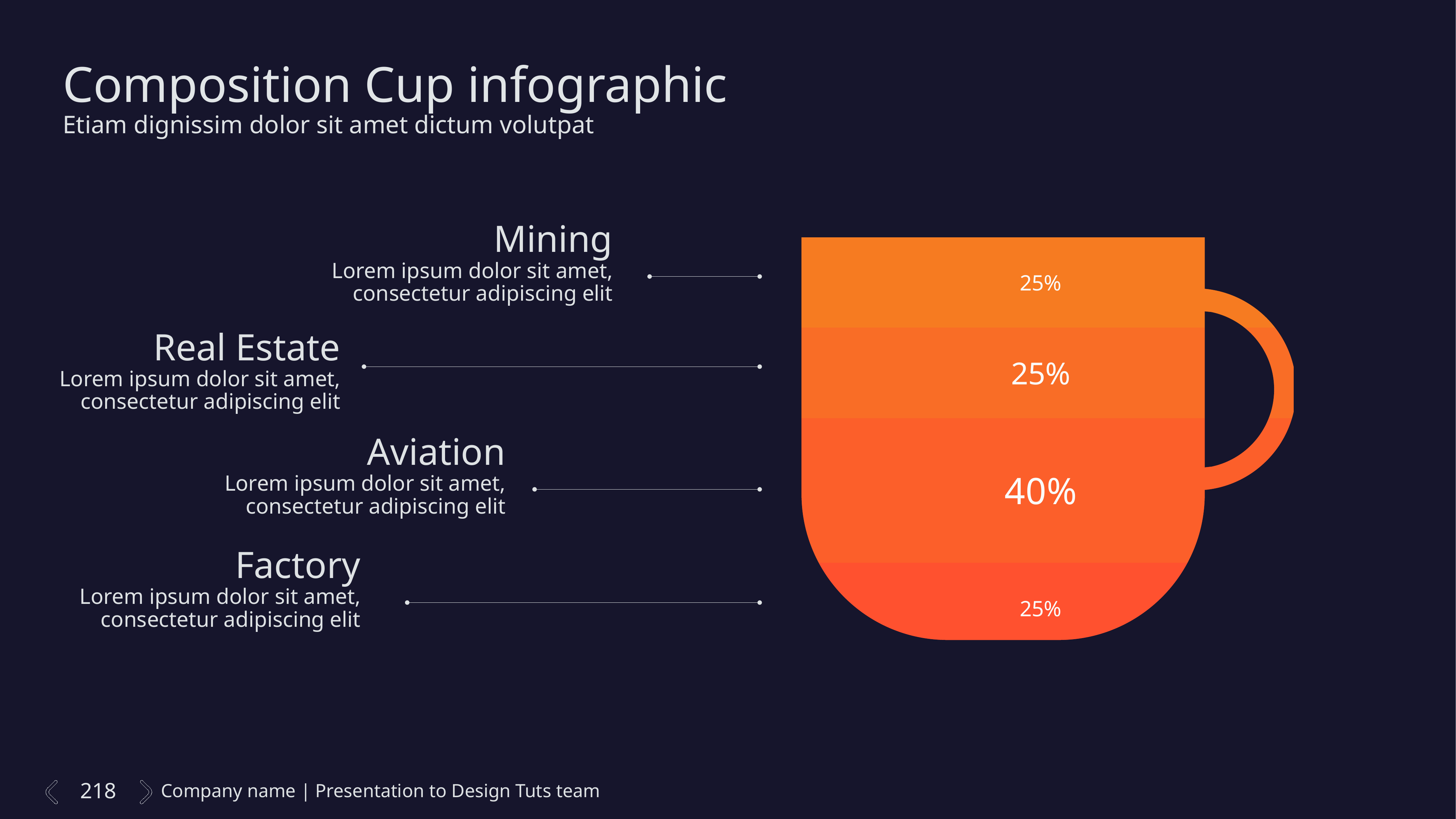
What percentage is shown for the Aviation segment of the cup? 40% Which is larger, the Aviation percentage or the Mining percentage? Aviation What is the difference between the Aviation percentage and the Factory percentage? 15% How many segments of the cup are labelled 25%? 3 How many categories are labelled in the cup infographic? 4 What percentage is shown for the Factory segment of the cup? 25% Is the Aviation percentage greater or less than 30%? greater What percentage is shown for the Real Estate segment of the cup? 25% Which category has the highest percentage in the cup infographic? Aviation Which category is connected to the top segment of the cup? Mining What percentage is shown for the Mining segment of the cup? 25% Which category is connected to the bottom segment of the cup? Factory